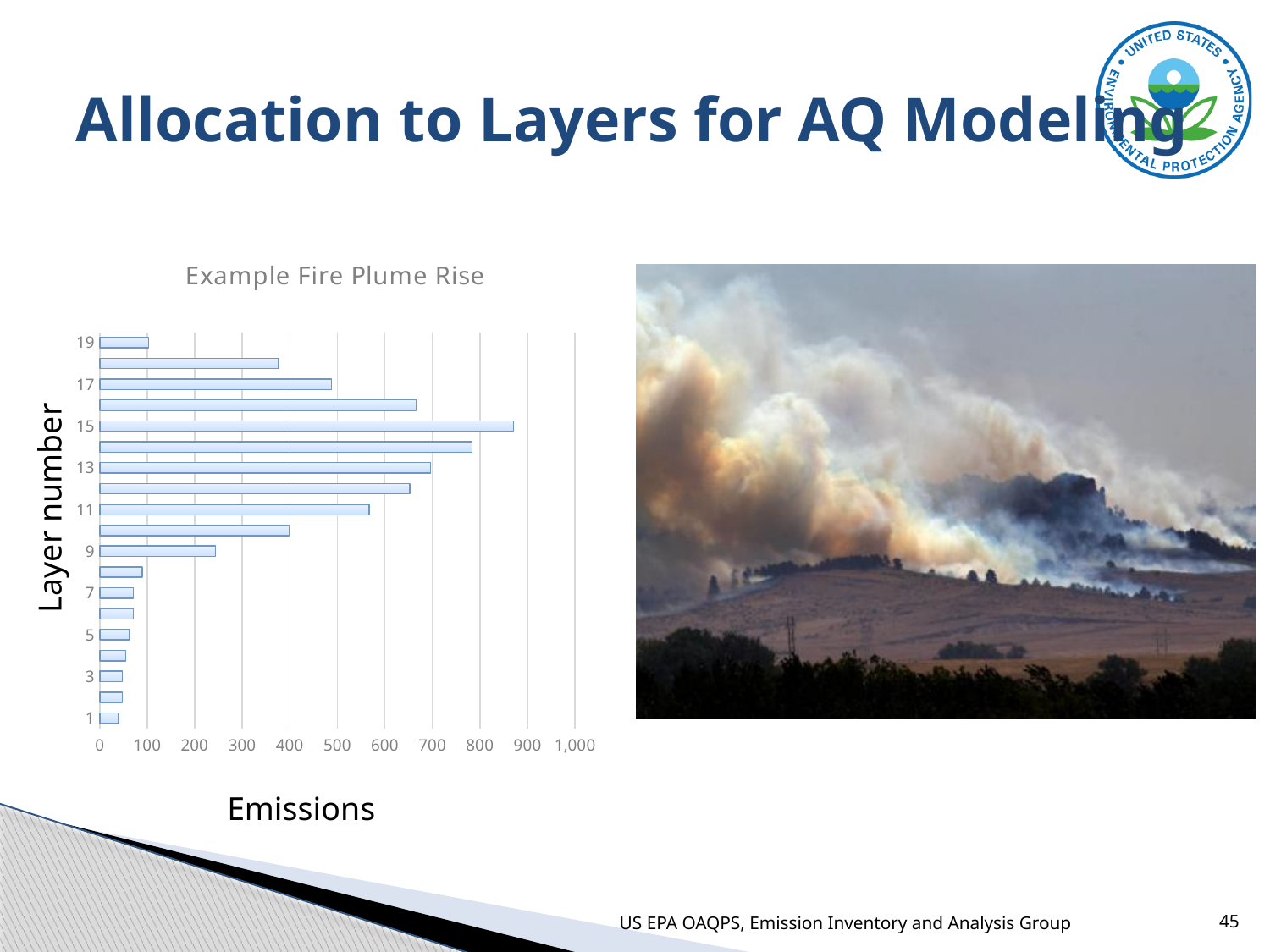
Is the value for layer 1 greater or less than 100? less What kind of chart is shown on the slide? bar chart Is the value for layer 13 greater or less than 600? greater Is the value for layer 9 greater or less than 300? less Which layer number has the highest emissions? 15 What is the title of the chart? Example Fire Plume Rise Which has higher emissions, layer 10 or layer 18? layer 10 What is the label of the horizontal axis of the chart? Emissions Which has higher emissions, layer 14 or layer 17? layer 14 How many layers are plotted in the chart? 19